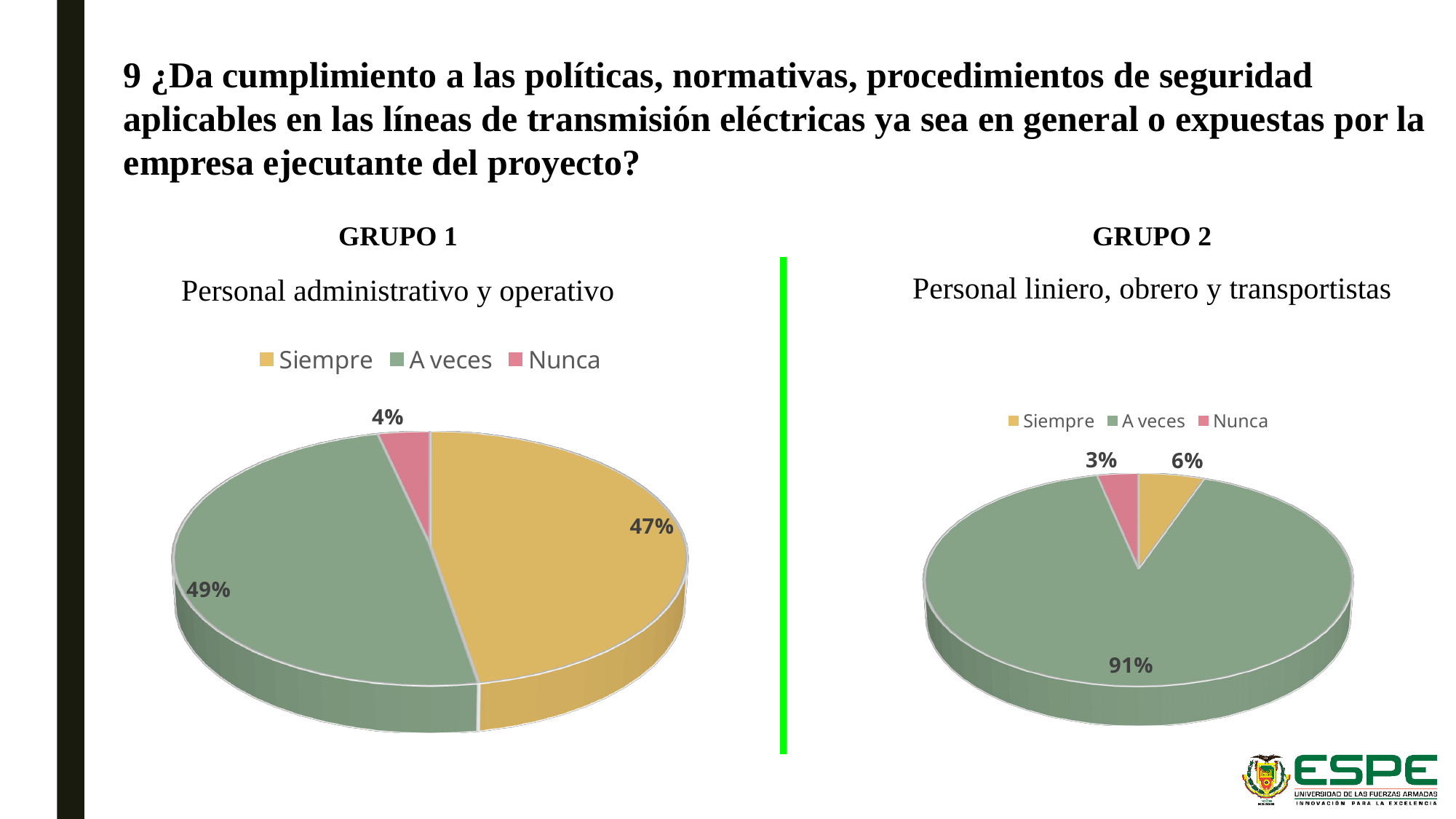
In the GRUPO 1 pie chart, what percentage is shown for Nunca? 4% In the GRUPO 1 pie chart, which category has the smallest share? Nunca In the GRUPO 2 pie chart, what percentage is shown for Nunca? 3% In the GRUPO 2 pie chart, is the share for Siempre larger or smaller than the share for Nunca? larger In the GRUPO 2 pie chart, what percentage is shown for Siempre? 6% How many categories does the legend of the GRUPO 2 chart list? 3 In the GRUPO 2 pie chart, which category has the largest share? A veces In the GRUPO 1 pie chart, what percentage is shown for A veces? 49% In the GRUPO 2 pie chart, what percentage is shown for A veces? 91% In the GRUPO 1 pie chart, what is the difference between the A veces and Siempre percentages? 2% What type of chart is used for GRUPO 1? Pie chart In the GRUPO 1 pie chart, what percentage is shown for Siempre? 47%